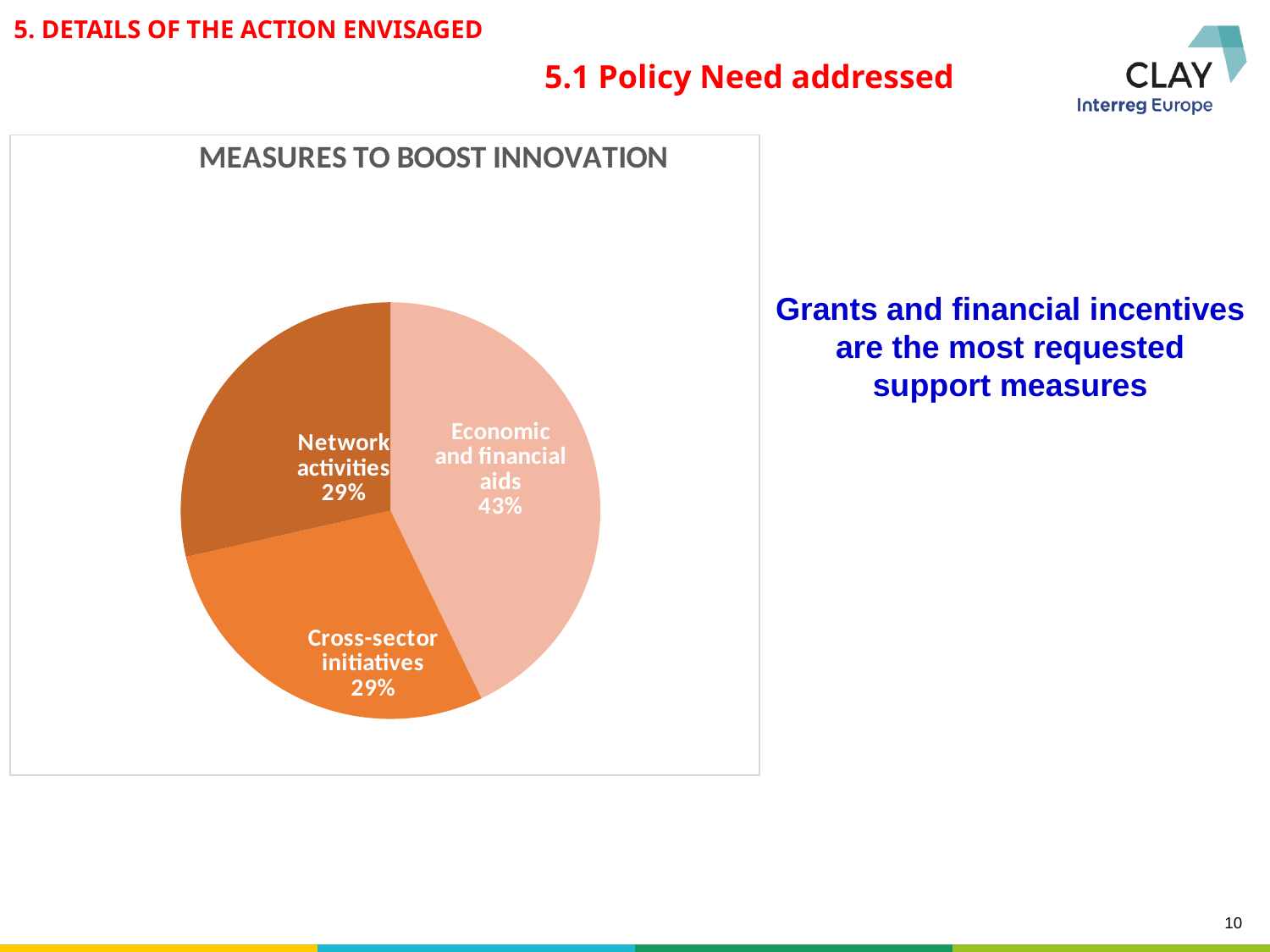
How many slices does the pie chart have? 3 What share of the pie is Network activities? 29% What is the difference in percentage points between Economic and financial aids and Network activities? 14 Which is larger, the slice for Economic and financial aids or the slice for Cross-sector initiatives? Economic and financial aids What share of the pie is Cross-sector initiatives? 29% What type of chart is shown on the slide? pie chart What is the title of the chart? MEASURES TO BOOST INNOVATION What share of the pie is Economic and financial aids? 43% Which category has the largest slice of the pie? Economic and financial aids Which slice of the pie is the lightest in colour? Economic and financial aids